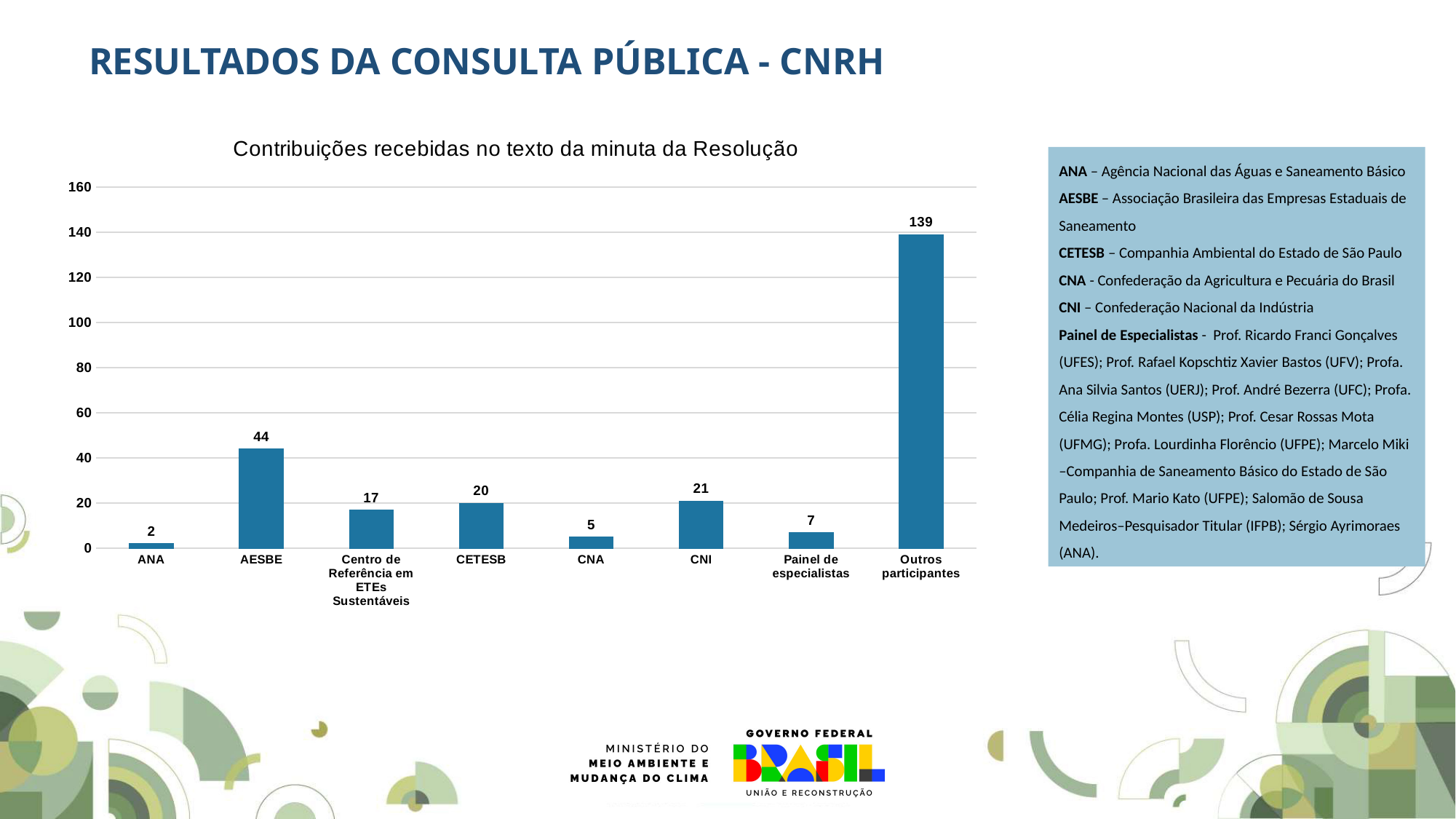
Which category has the highest value? Outros participantes What is the value for Centro de Referência em ETEs Sustentáveis? 17 Which is larger, the value for CNA or the value for Painel de especialistas? Painel de especialistas Which category has the lowest value? ANA What kind of chart is shown? bar chart What is the title of the chart? Contribuições recebidas no texto da minuta da Resolução What is the difference between the values for CNI and CETESB? 1 What is the difference between the values for Outros participantes and AESBE? 95 What is the value for Painel de especialistas? 7 What is the value for Outros participantes? 139 How many categories are shown on the x axis? 8 What is the value for AESBE? 44